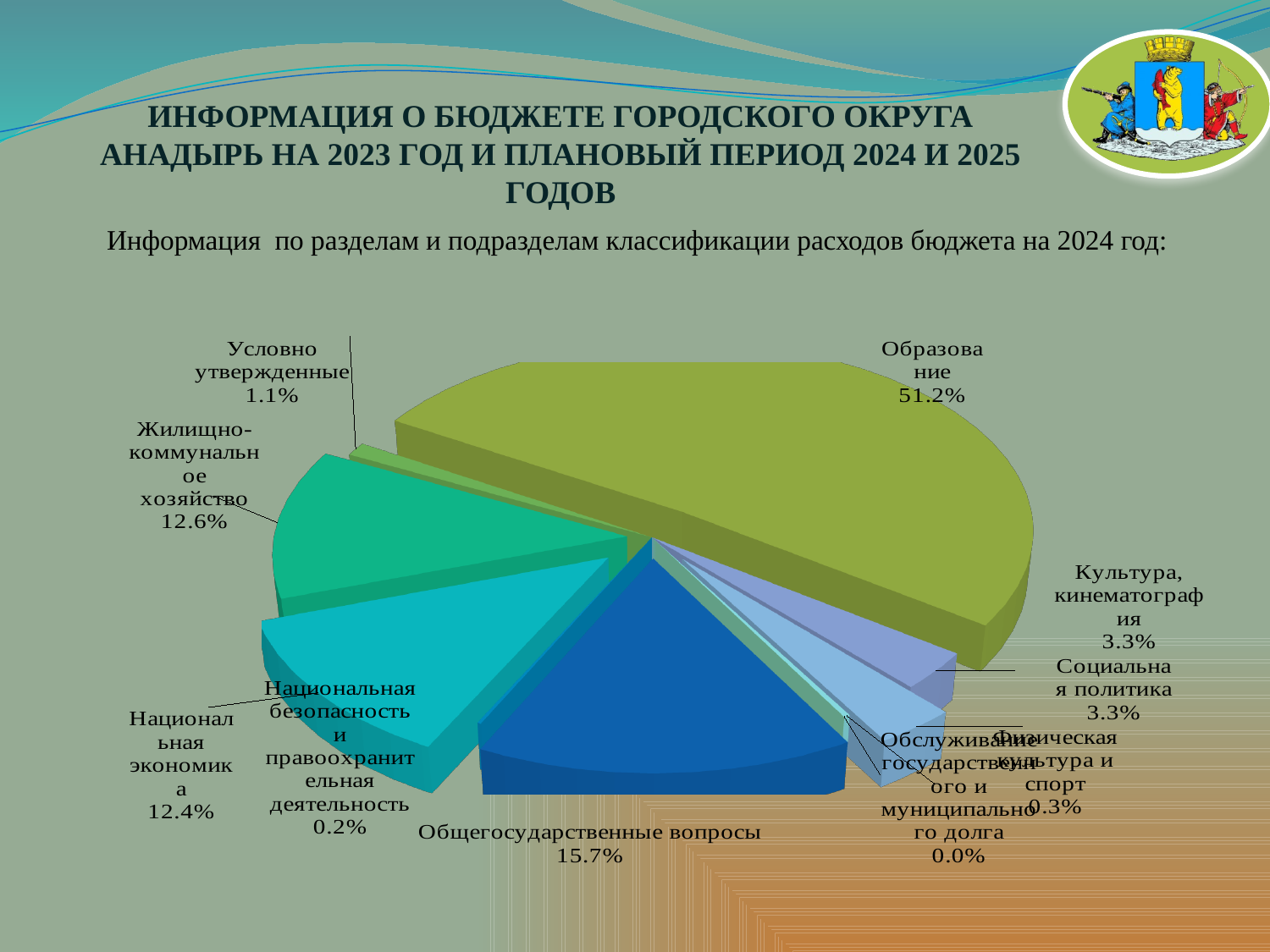
Which category has the smallest share of the pie? Обслуживание государственного и муниципального долга What is the value shown for Общегосударственные вопросы? 15.7% What is the value shown for Национальная экономика? 12.4% Which is larger: the share for Жилищно-коммунальное хозяйство or for Национальная экономика? Жилищно-коммунальное хозяйство Which category has the largest share of the pie? Образование How many categories (slices) does the pie chart show? 10 What is the difference between the shares of Образование and Общегосударственные вопросы? 35.5% What is the value shown for Условно утвержденные? 1.1% What share of the 2024 budget expenditures goes to Образование? 51.2% What is the value shown for Физическая культура и спорт? 0.3% What kind of chart is shown on the slide? pie chart What is the value shown for Жилищно-коммунальное хозяйство? 12.6%